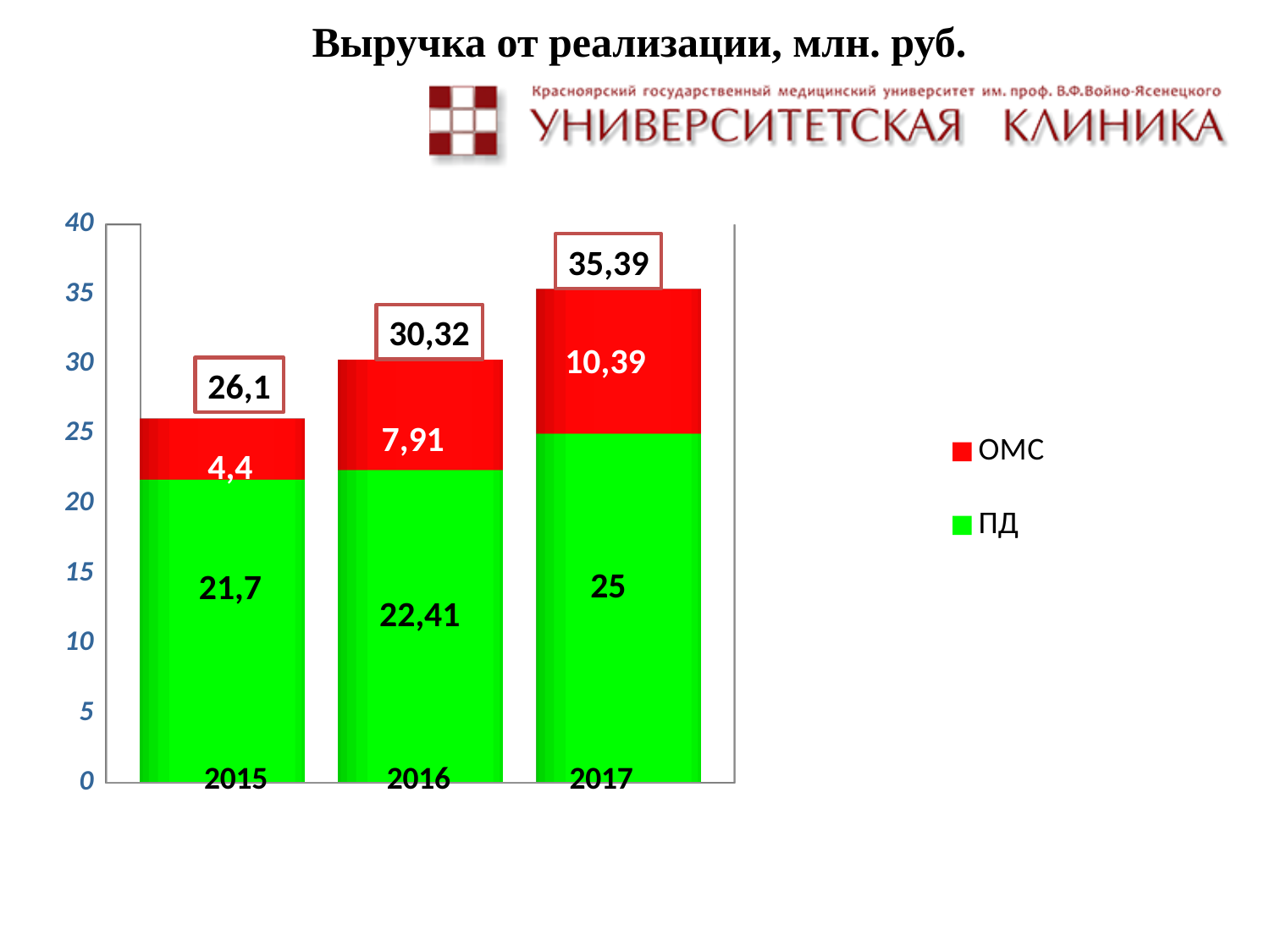
What is the difference between the ОМС values for 2017 and 2016? 2,48 What is the ОМС value for 2015? 4,4 Do the total values rise or fall from 2015 to 2017? rise What is the total of the stacked bar for 2017? 35,39 Which is larger, the ПД value for 2017 or the ПД value for 2016? 2017 Which year has the highest ОМС value? 2017 What is the total of the stacked bar for 2015? 26,1 What is the ПД value for 2016? 22,41 How many series does the legend list? 2 Which year has the lowest ПД value? 2015 How many years are shown on the x axis? 3 What is the ОМС value for 2017? 10,39